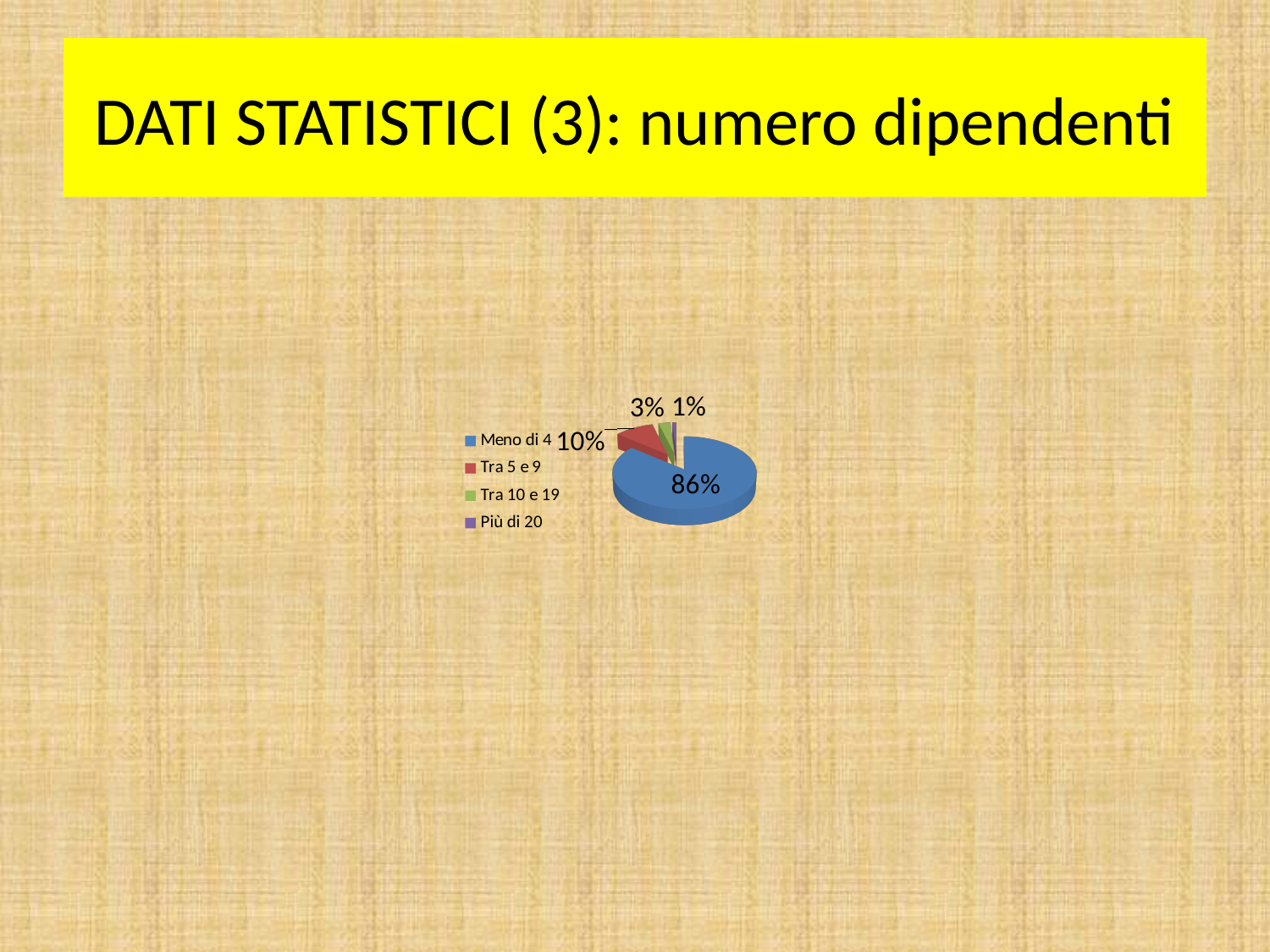
What share of the pie does the 'Tra 5 e 9' slice represent? 10% Which category has the smallest slice of the pie? Più di 20 What share of the pie does the 'Più di 20' slice represent? 1% What share of the pie does the 'Meno di 4' slice represent? 86% What is the difference in percentage points between the 'Meno di 4' slice and the 'Tra 5 e 9' slice? 76 How many categories does the pie chart show? 4 What kind of chart is shown on the slide? pie chart What is the title of the slide containing the pie chart? DATI STATISTICI (3): numero dipendenti What colour is the 'Meno di 4' slice in the pie chart? blue Which category has the largest slice of the pie? Meno di 4 Which slice is larger, 'Tra 5 e 9' or 'Tra 10 e 19'? Tra 5 e 9